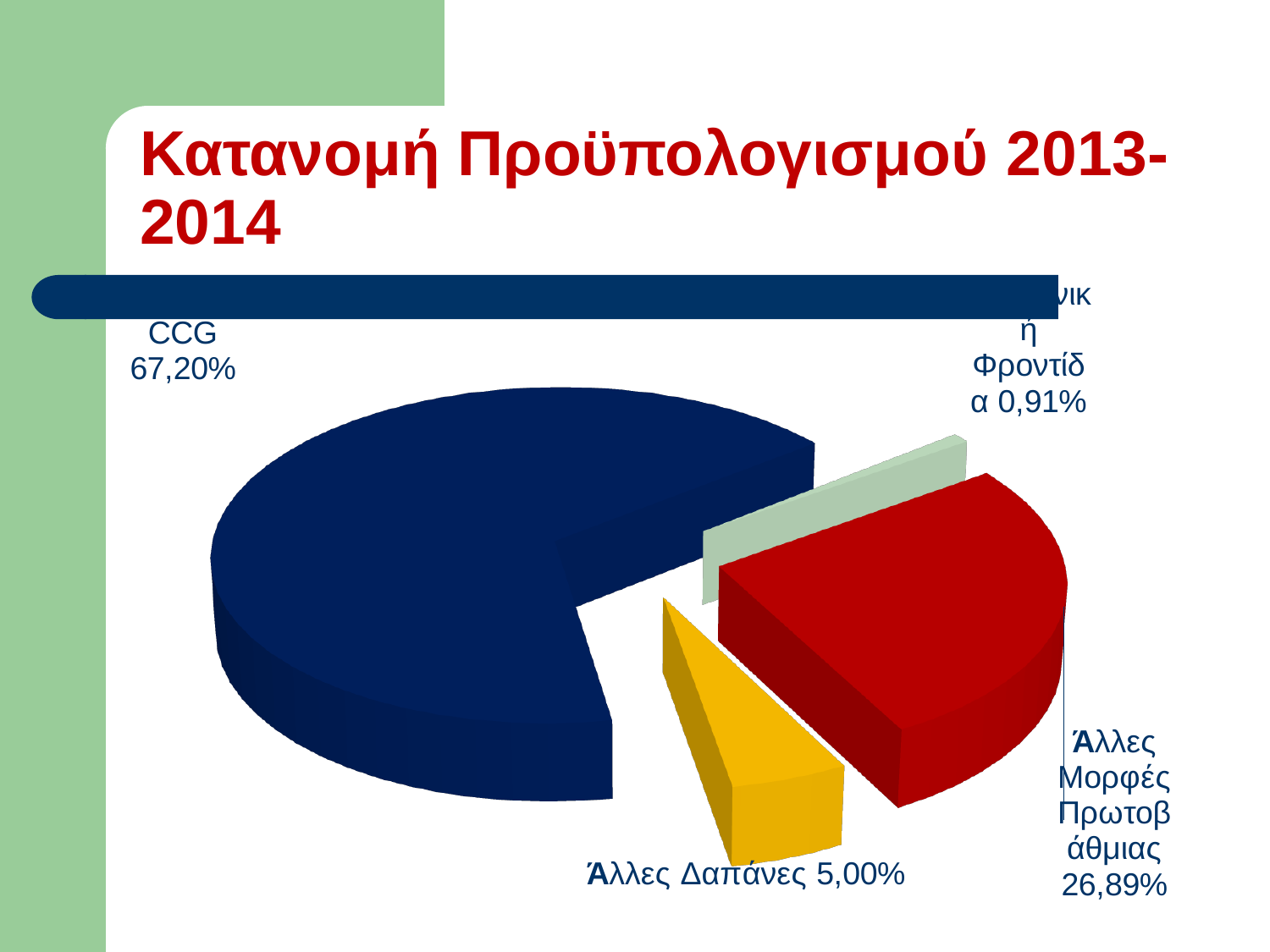
Is the share for CCG greater or less than 50%? greater What percentage of the budget does the CCG slice represent? 67,20% What kind of chart is shown on the slide? pie chart What percentage is shown for Άλλες Δαπάνες? 5,00% What is the smallest percentage value labelled on the pie chart? 0,91% What is the difference in percentage points between CCG and Άλλες Μορφές Πρωτοβάθμιας? 40,31% Which category has the largest share of the pie? CCG What percentage is shown for Άλλες Μορφές Πρωτοβάθμιας? 26,89% How many slices does the pie chart have? 4 What is the title of the slide containing the pie chart? Κατανομή Προϋπολογισμού 2013-2014 What is the difference in percentage points between Άλλες Μορφές Πρωτοβάθμιας and Άλλες Δαπάνες? 21,89% Which is larger, Άλλες Δαπάνες or Άλλες Μορφές Πρωτοβάθμιας? Άλλες Μορφές Πρωτοβάθμιας